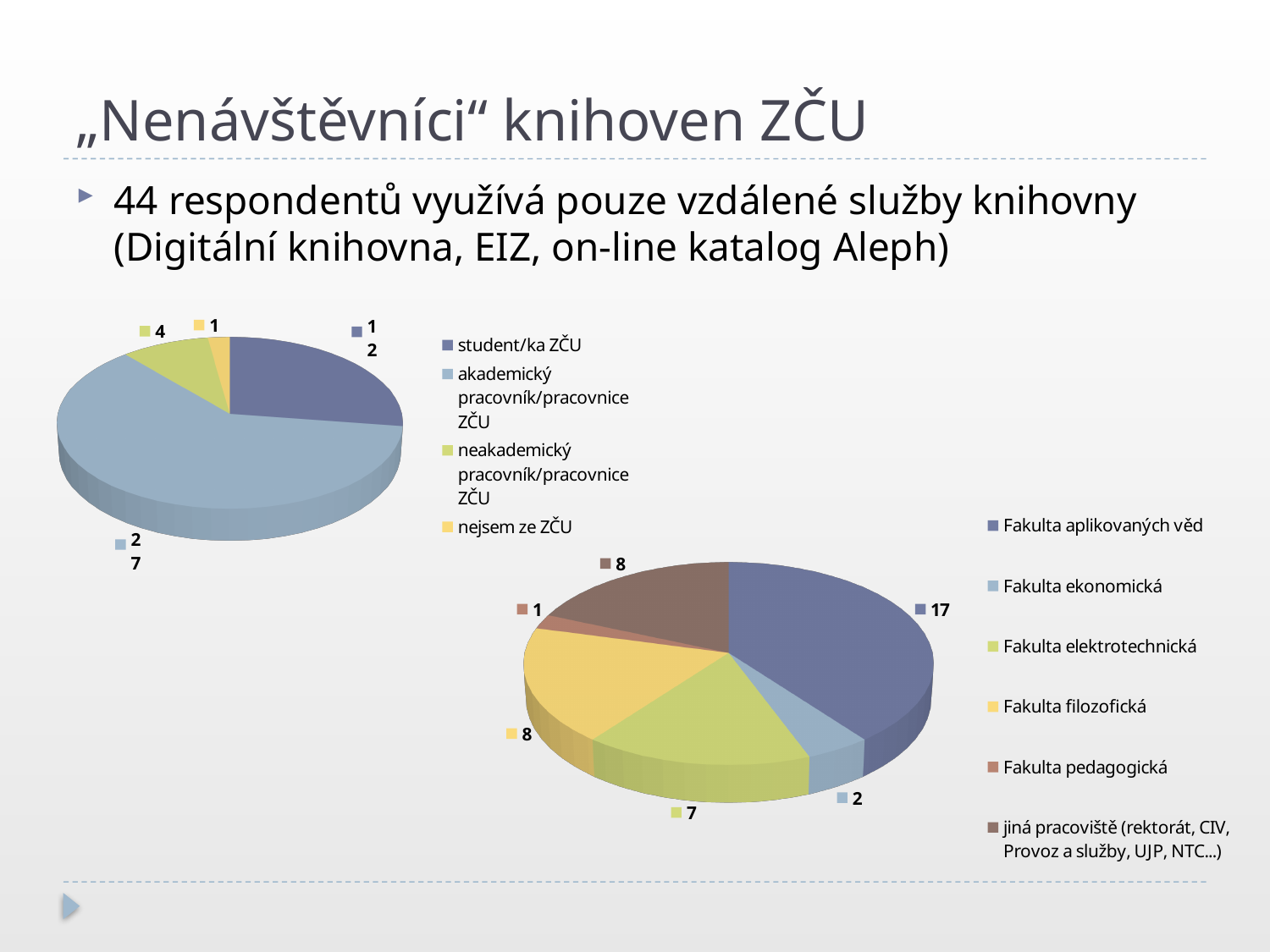
How many categories does the legend of the upper-left pie chart list? 4 In the lower-right pie chart, what is the value for Fakulta elektrotechnická? 7 In the lower-right pie chart, which is larger: Fakulta elektrotechnická or Fakulta ekonomická? Fakulta elektrotechnická In the lower-right pie chart, what is the value for Fakulta pedagogická? 1 In the upper-left pie chart, what is the value for neakademický pracovník/pracovnice ZČU? 4 In the lower-right pie chart, which category has the largest slice? Fakulta aplikovaných věd In the lower-right pie chart, what is the difference between Fakulta aplikovaných věd and Fakulta filozofická? 9 What kind of chart is the chart in the upper left of the slide? pie chart In the upper-left pie chart, which category has the largest slice? akademický pracovník/pracovnice ZČU How many categories does the legend of the lower-right pie chart list? 6 In the lower-right pie chart, what is the value for Fakulta aplikovaných věd? 17 In the lower-right pie chart, which category has the smallest slice? Fakulta pedagogická